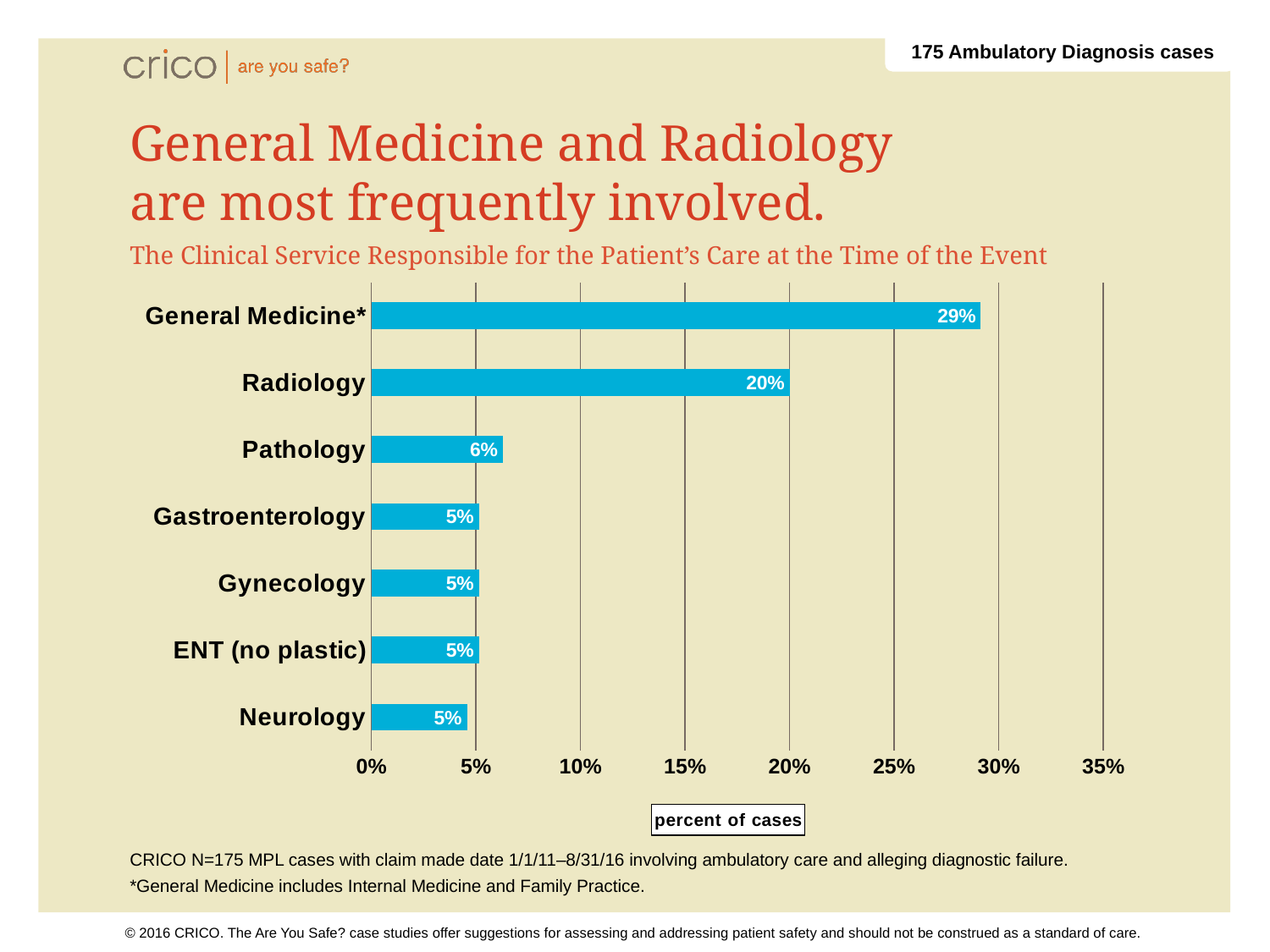
What kind of chart is shown on the slide? bar chart How many clinical services are shown in the chart? 7 Which is larger, the value for Radiology or the value for Pathology? Radiology What is the value for Gastroenterology? 5% What is the difference between the values for General Medicine* and Radiology? 9% What is the value for General Medicine*? 29% What is the value for Pathology? 6% What is the value for Radiology? 20% Is the value for General Medicine* greater or less than 25%? greater Which clinical service has the highest percent of cases? General Medicine* What is the difference between the values for Radiology and Pathology? 14% What is the label shown below the x axis of the chart? percent of cases